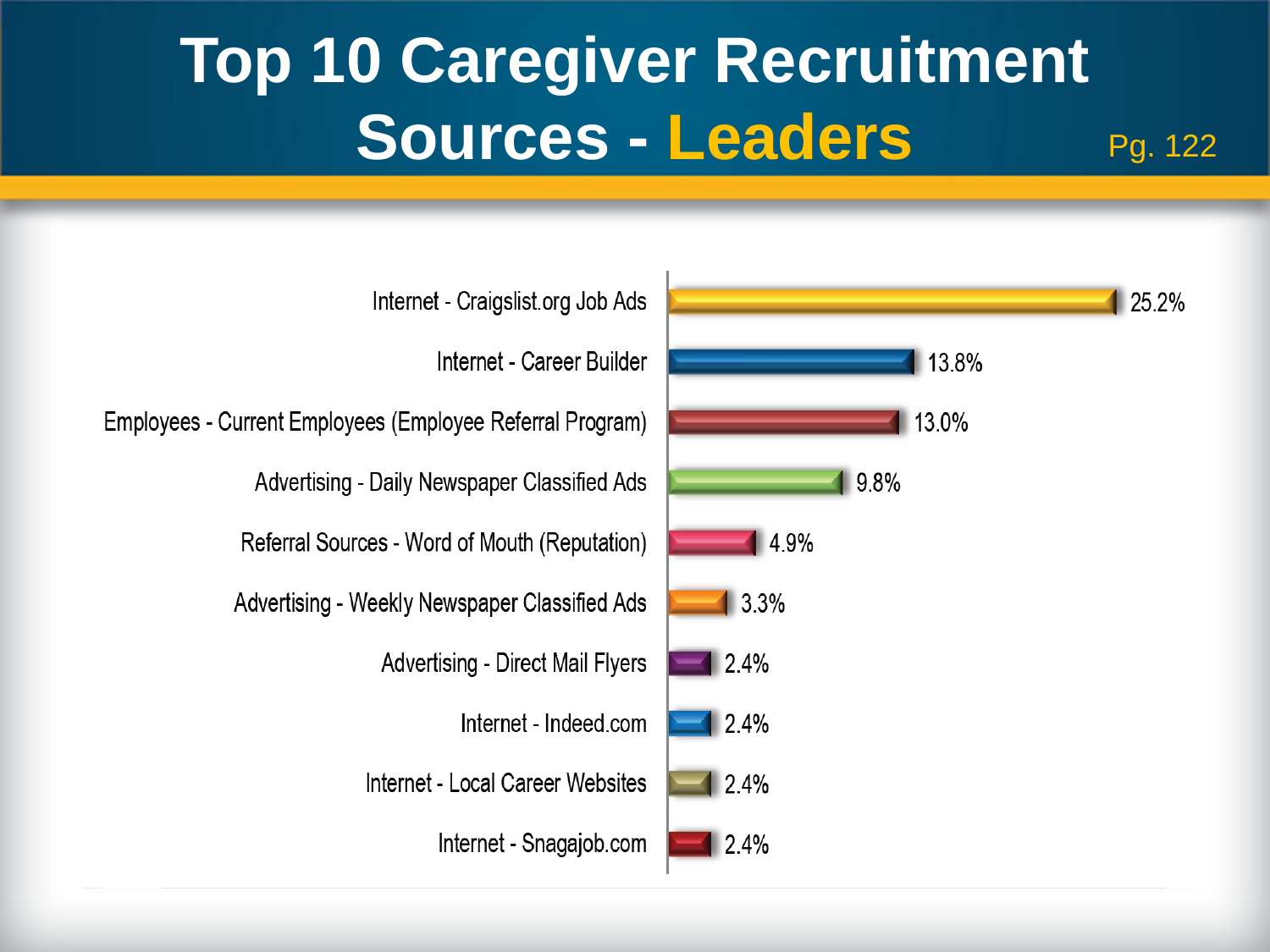
What is the value for Internet - Craigslist.org Job Ads? 25.2% What is the value for Advertising - Daily Newspaper Classified Ads? 9.8% How many recruitment sources are shown in the chart? 10 What kind of chart is shown on the slide? Bar chart Which recruitment source has the highest value? Internet - Craigslist.org Job Ads What is the difference between the values for Internet - Craigslist.org Job Ads and Internet - Career Builder? 11.4% How many recruitment sources share the value 2.4%? 4 What is the value for Internet - Career Builder? 13.8% What is the value for Advertising - Weekly Newspaper Classified Ads? 3.3% What is the value for Referral Sources - Word of Mouth (Reputation)? 4.9% Which is larger, the value for Advertising - Daily Newspaper Classified Ads or the value for Referral Sources - Word of Mouth (Reputation)? Advertising - Daily Newspaper Classified Ads What is the value for Employees - Current Employees (Employee Referral Program)? 13.0%